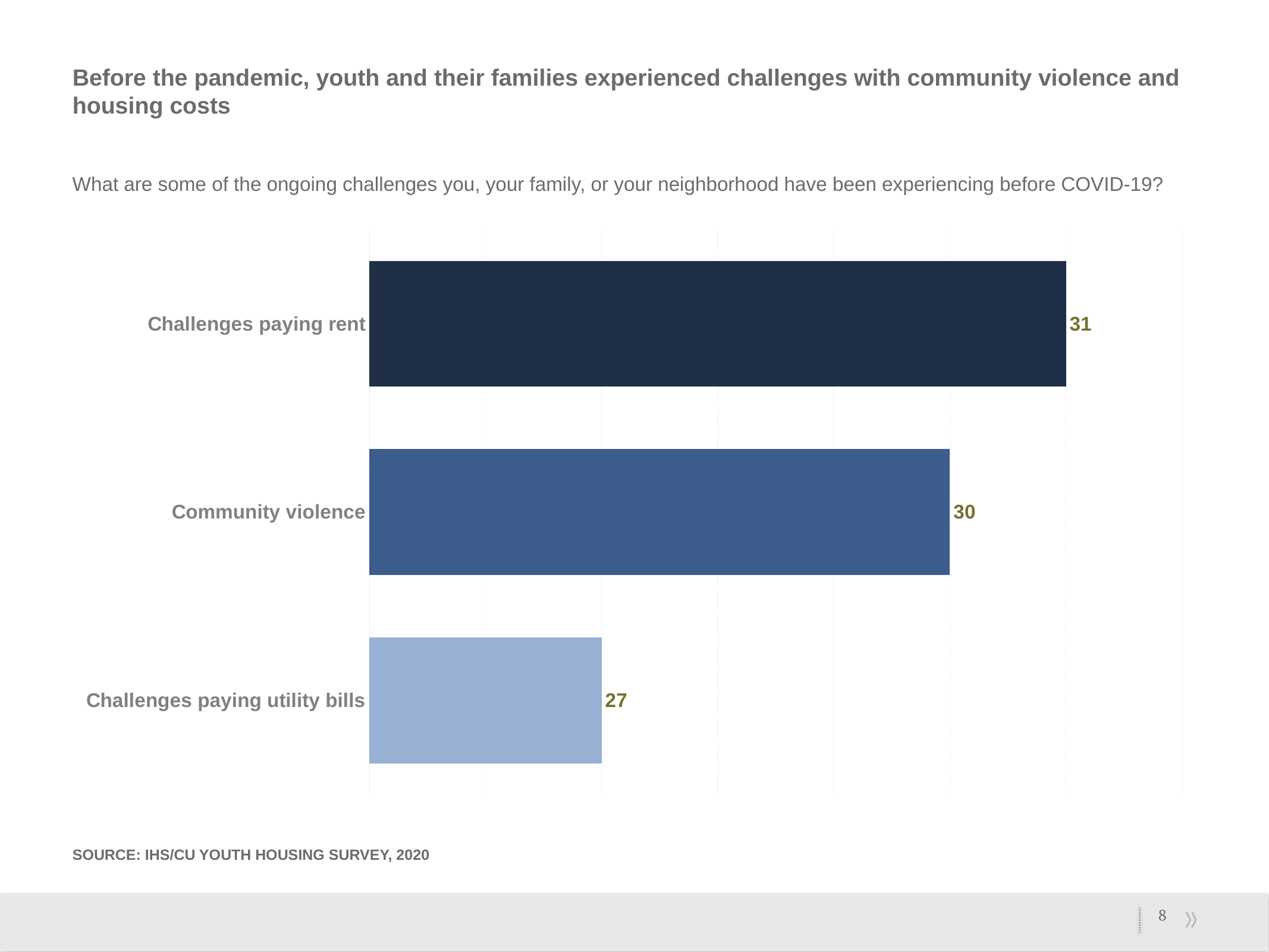
What is the difference between the values for Community violence and Challenges paying utility bills? 3 What is the difference between the values for Challenges paying rent and Challenges paying utility bills? 4 What is the value for Community violence? 30 What is the source cited for the chart? IHS/CU Youth Housing Survey, 2020 What is the value for Challenges paying rent? 31 Which category has the highest value? Challenges paying rent Which is larger: the value for Community violence or the value for Challenges paying utility bills? Community violence What is the value for Challenges paying utility bills? 27 Which category is shown with the darkest bar? Challenges paying rent Which category has the lowest value? Challenges paying utility bills How many categories are shown in the chart? 3 What kind of chart is shown on the slide? Bar chart